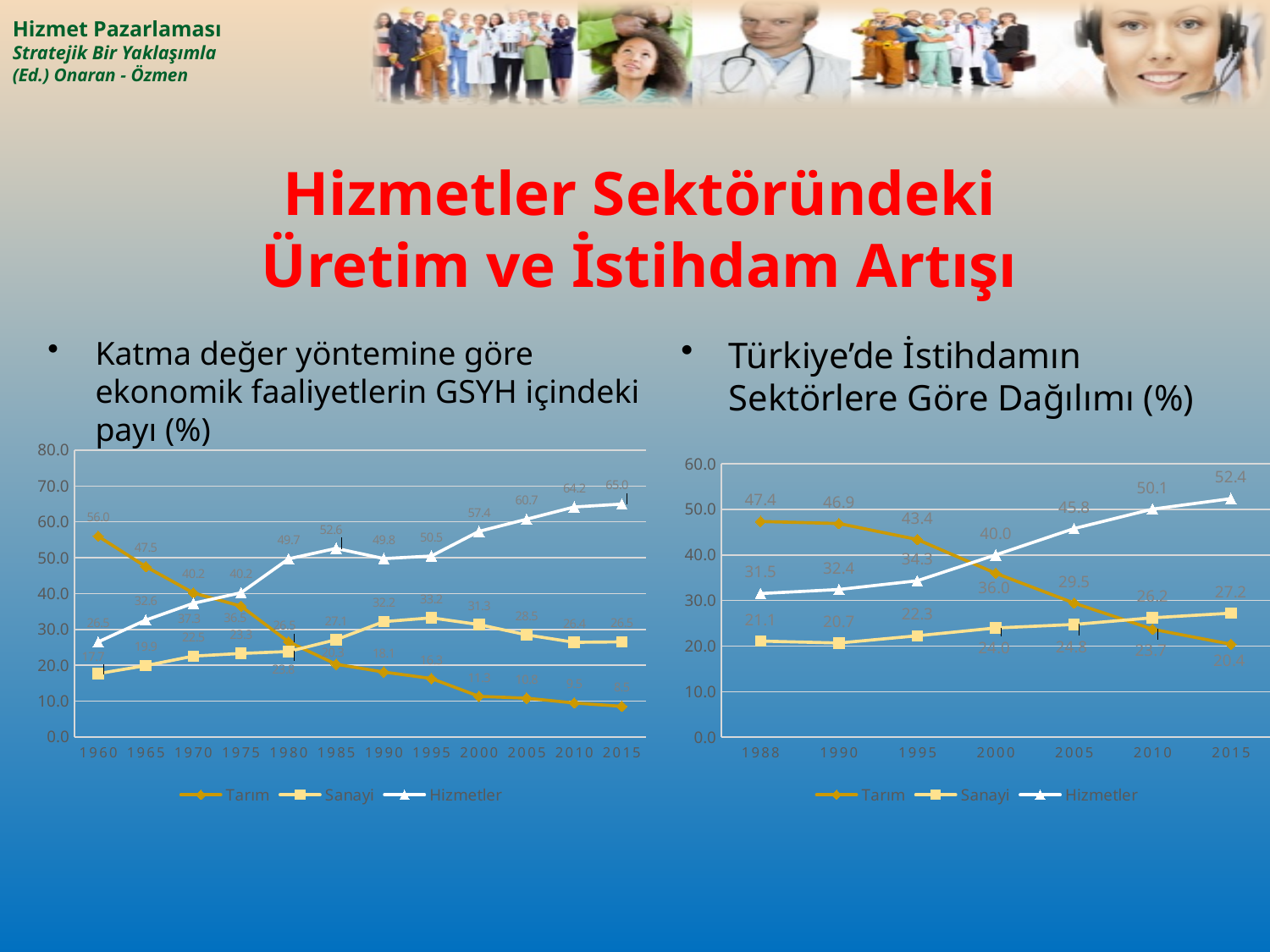
In the right chart (Türkiye'de İstihdamın Sektörlere Göre Dağılımı), how many years are shown on the x axis? 7 In the right chart (Türkiye'de İstihdamın Sektörlere Göre Dağılımı), what is the value for Hizmetler in 2015? 52.4 How many series does the legend of the left chart list? 3 In the right chart (Türkiye'de İstihdamın Sektörlere Göre Dağılımı), what is the value for Sanayi in 2015? 27.2 In the left chart (Katma değer yöntemine göre ekonomik faaliyetlerin GSYH içindeki payı), is the value for Tarım in 2015 greater or less than 20.0? less What type of chart is the right chart (Türkiye'de İstihdamın Sektörlere Göre Dağılımı)? line chart In the left chart (Katma değer yöntemine göre ekonomik faaliyetlerin GSYH içindeki payı), what is the value for Hizmetler in 2015? 65.0 In the right chart (Türkiye'de İstihdamın Sektörlere Göre Dağılımı), which series has the highest value in 1988? Tarım In the right chart (Türkiye'de İstihdamın Sektörlere Göre Dağılımı), what is the difference between Hizmetler and Tarım in 2000? 4.0 In the right chart (Türkiye'de İstihdamın Sektörlere Göre Dağılımı), does the Tarım series rise or fall from 1988 to 2015? fall In the left chart (Katma değer yöntemine göre ekonomik faaliyetlerin GSYH içindeki payı), what is the value for Tarım in 1960? 56.0 In the right chart (Türkiye'de İstihdamın Sektörlere Göre Dağılımı), what is the value for Tarım in 1988? 47.4